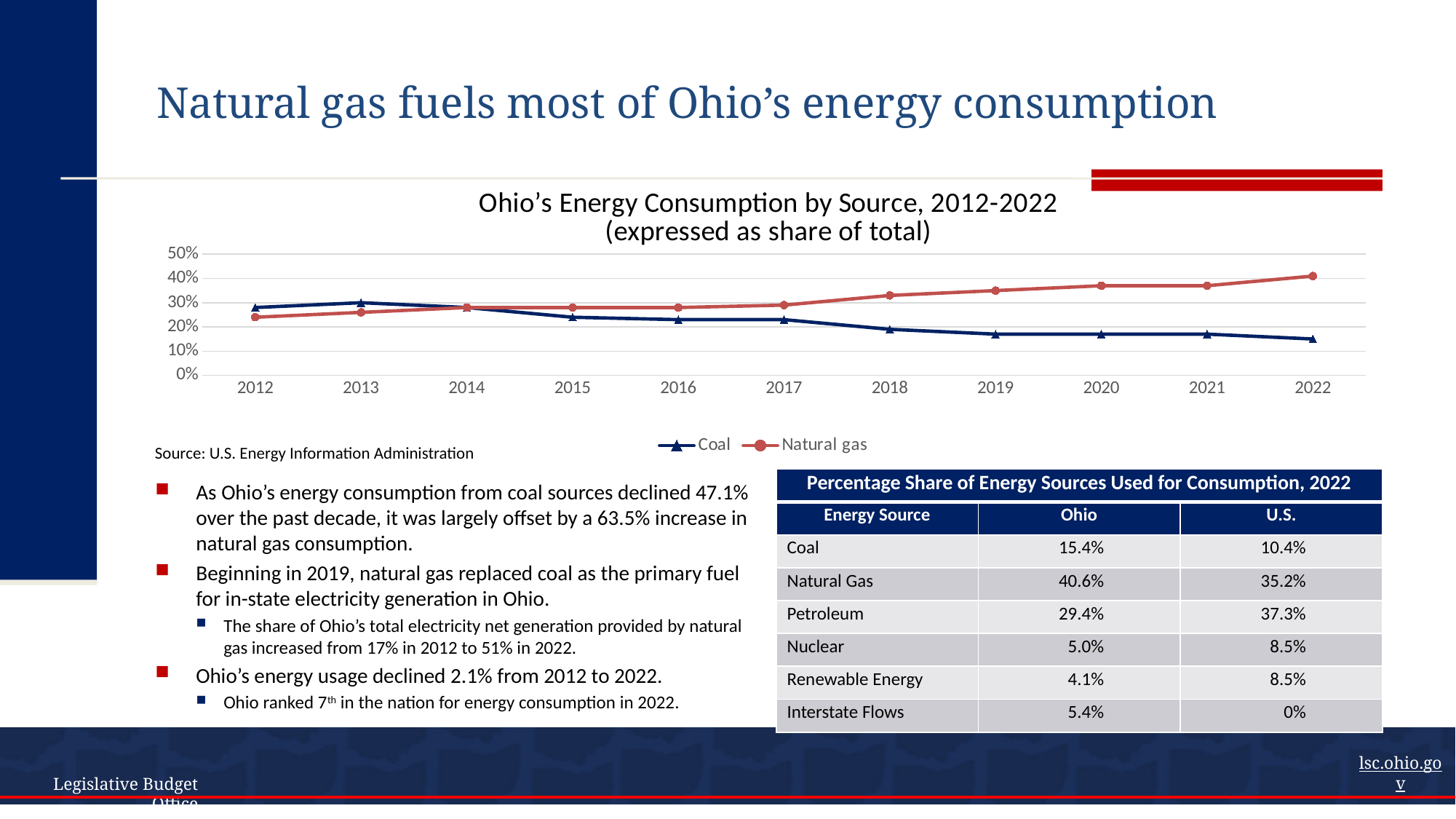
How many years are plotted along the x axis of the chart? 11 Which two series are listed in the chart's legend? Coal and Natural gas What kind of chart is shown on the slide? line chart Is the value for Natural gas in 2022 greater or less than 30%? greater In which year does the Natural gas series reach its highest share? 2022 What is the title of the chart? Ohio's Energy Consumption by Source, 2012-2022 (expressed as share of total) Is the value for Coal in 2022 greater or less than 20%? less How many series does the chart's legend list? 2 Is the value for Coal in 2013 greater or less than 20%? greater In 2022, which series has the higher share, Coal or Natural gas? Natural gas In 2012, which series has the higher share, Coal or Natural gas? Coal Does the Coal series rise or fall from 2012 to 2022? fall